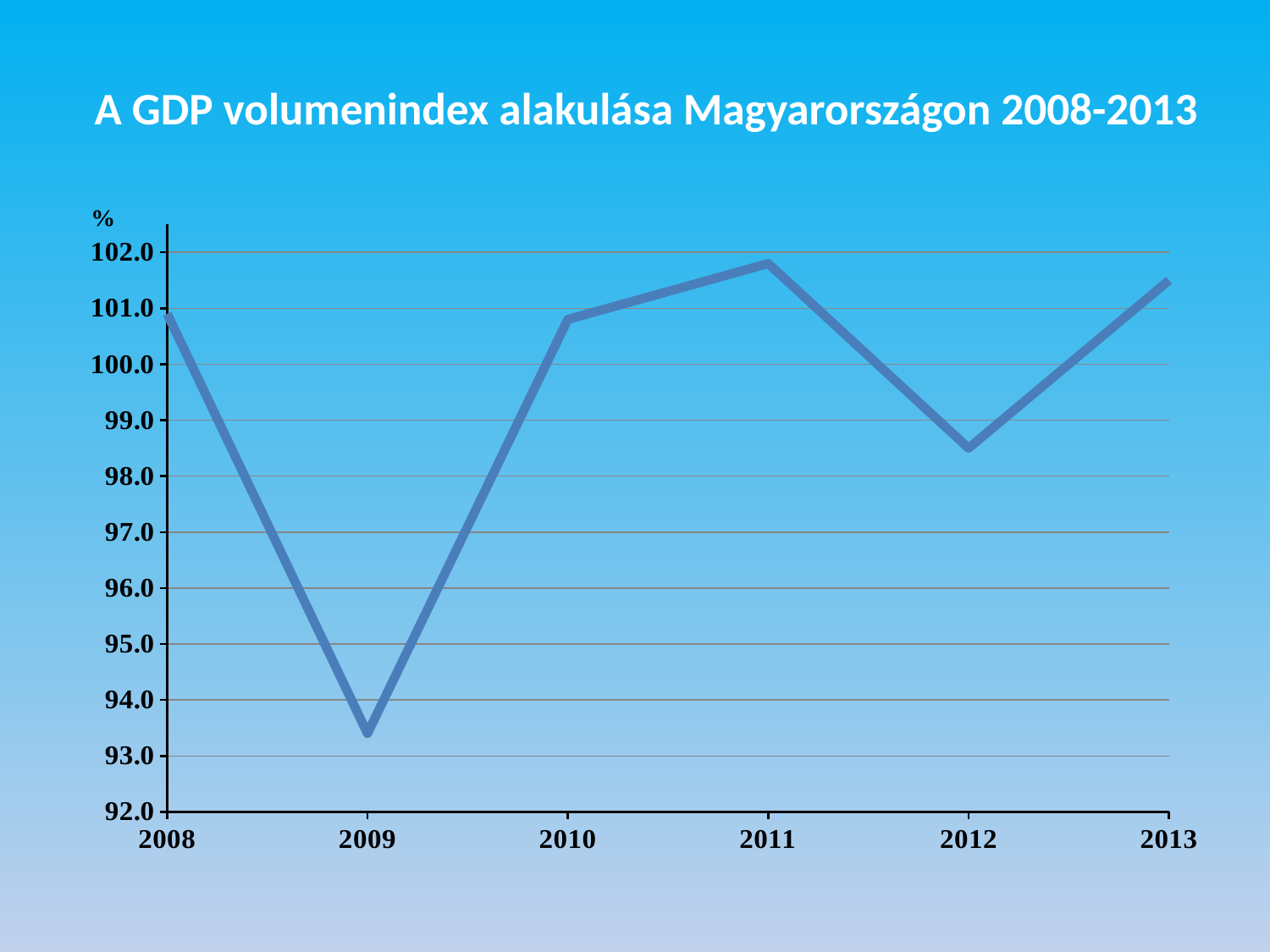
Is the value for 2011 greater or less than 101.0? greater Which year has the lowest GDP volume index value? 2009 How many years (data points) are plotted on the x axis? 6 Is the value for 2008 greater or less than 100.0? greater Is the value for 2012 greater or less than 99.0? less Which year has the highest GDP volume index value? 2011 Does the line rise or fall from 2011 to 2012? fall What unit is shown at the top of the y axis? % What kind of chart is shown on the slide? line chart Which is larger, the value for 2012 or the value for 2013? 2013